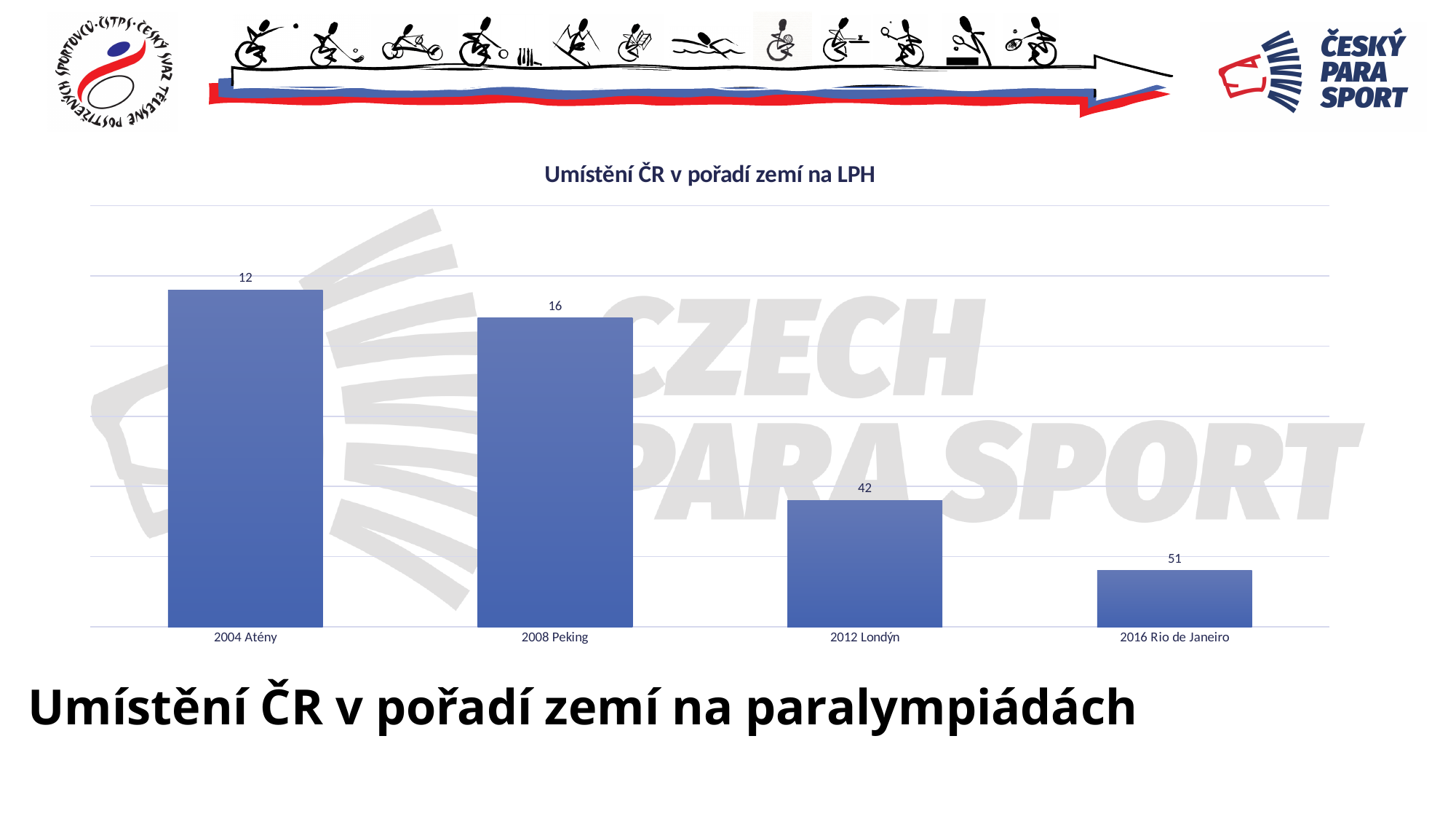
What is the value for 2004 Atény? 12 What is the value for 2008 Peking? 16 What is the difference between the values for 2016 Rio de Janeiro and 2004 Atény? 39 What kind of chart is shown? bar chart What is the value for 2012 Londýn? 42 How many categories are shown on the x axis? 4 What is the value for 2016 Rio de Janeiro? 51 What is the difference between the values for 2012 Londýn and 2008 Peking? 26